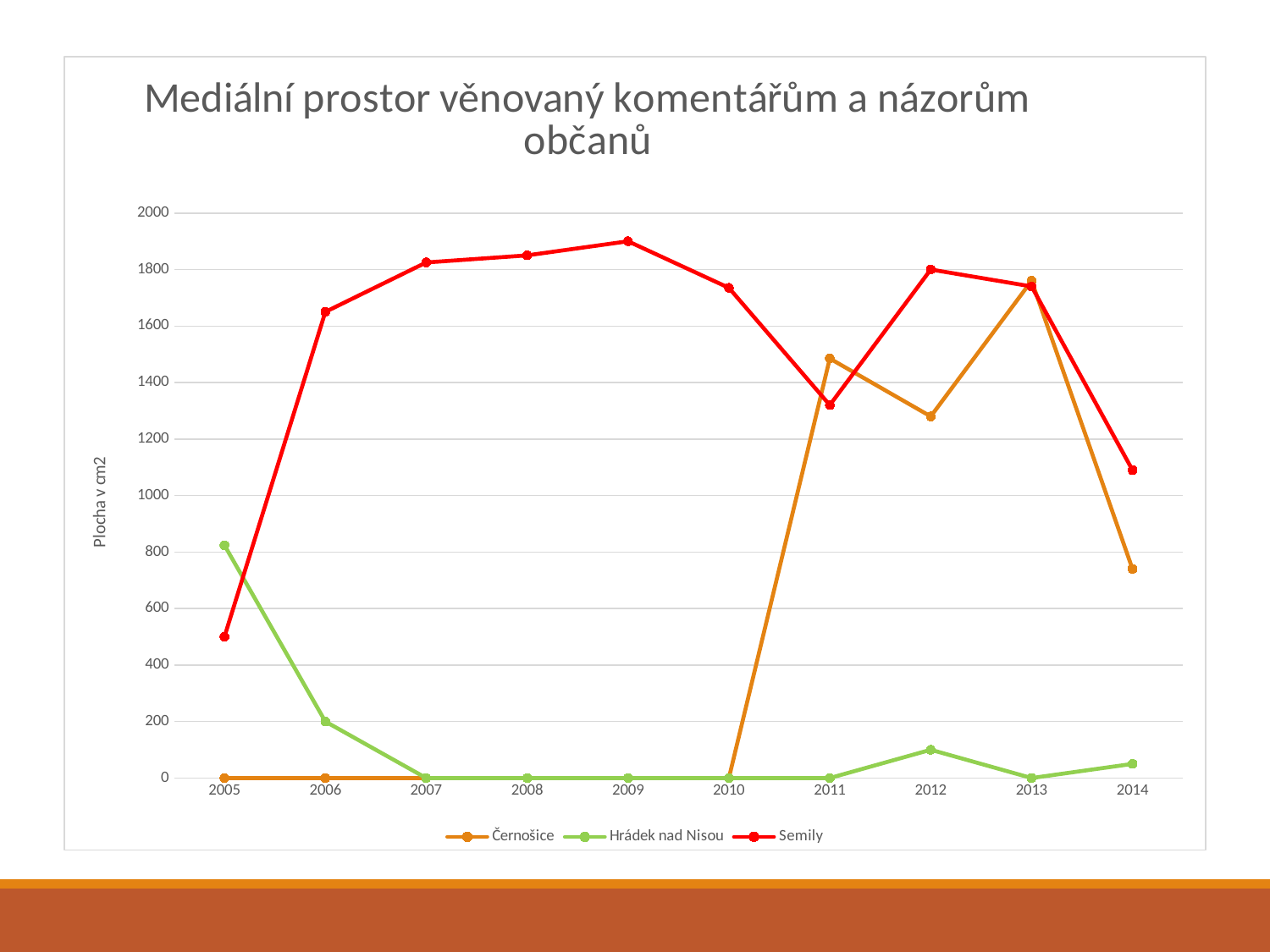
What is the value for Semily in 2012? 1800 What is the value for Hrádek nad Nisou in 2006? 200 What is the label on the y axis? Plocha v cm2 What is the value for Černošice in 2008? 0 How many series does the legend list? 3 Which series has the larger value in 2012, Semily or Černošice? Semily In which year does Semily have its lowest value? 2005 What kind of chart is shown on the slide? line chart How many years are shown on the x axis? 10 In which year does Semily reach its highest value? 2009 Is the value for Černošice in 2014 greater or less than 800? less